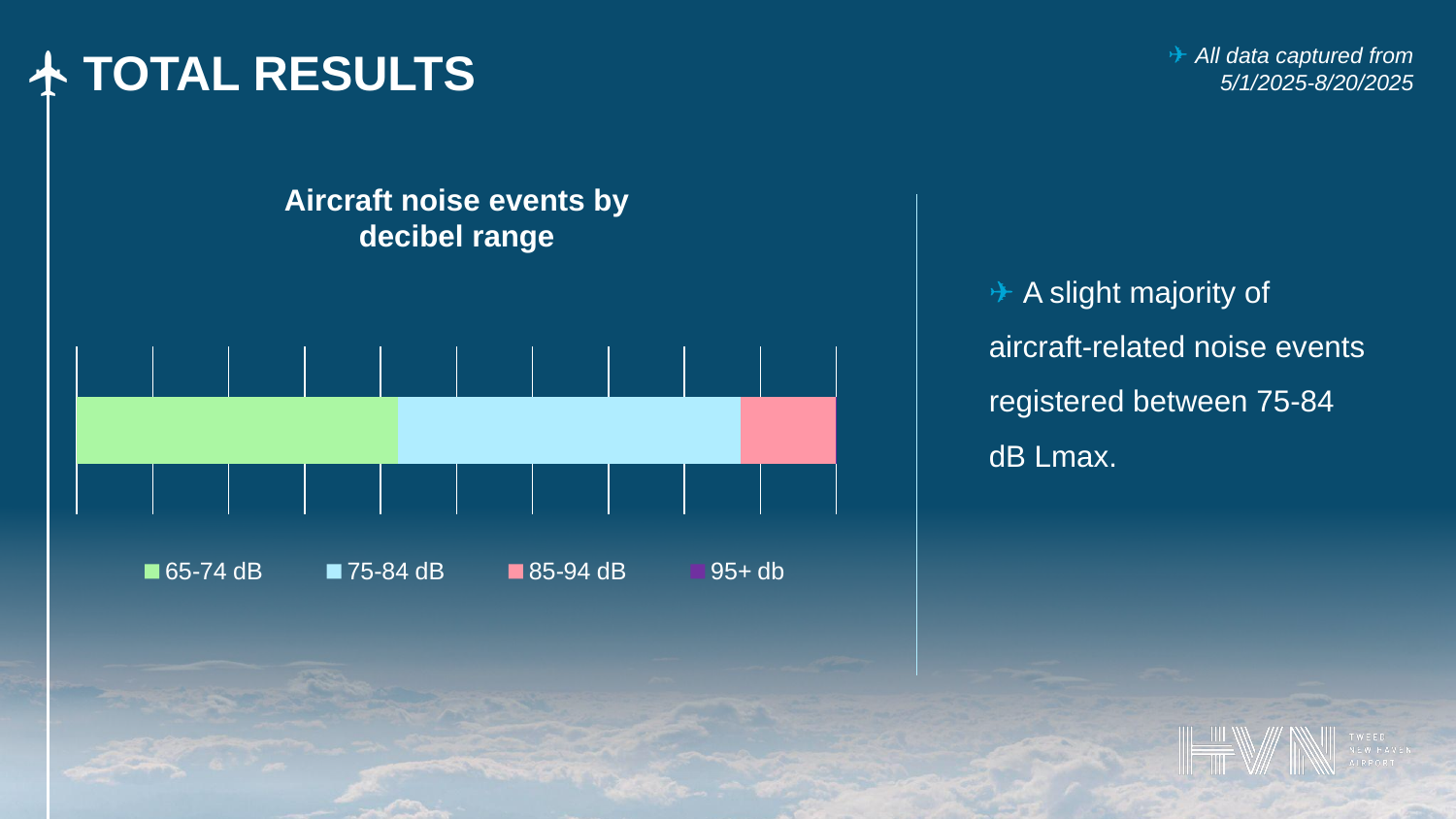
How many series does the legend of the chart list? 4 Which decibel range accounts for the largest segment of the bar? 75-84 dB What colour represents the 65-74 dB range in the chart? Green Which segment is larger, 75-84 dB or 85-94 dB? 75-84 dB Which segment is larger, 65-74 dB or 75-84 dB? 75-84 dB What is the title of the chart? Aircraft noise events by decibel range Which segment is larger, 65-74 dB or 85-94 dB? 65-74 dB What kind of chart is shown on the slide? Stacked bar chart